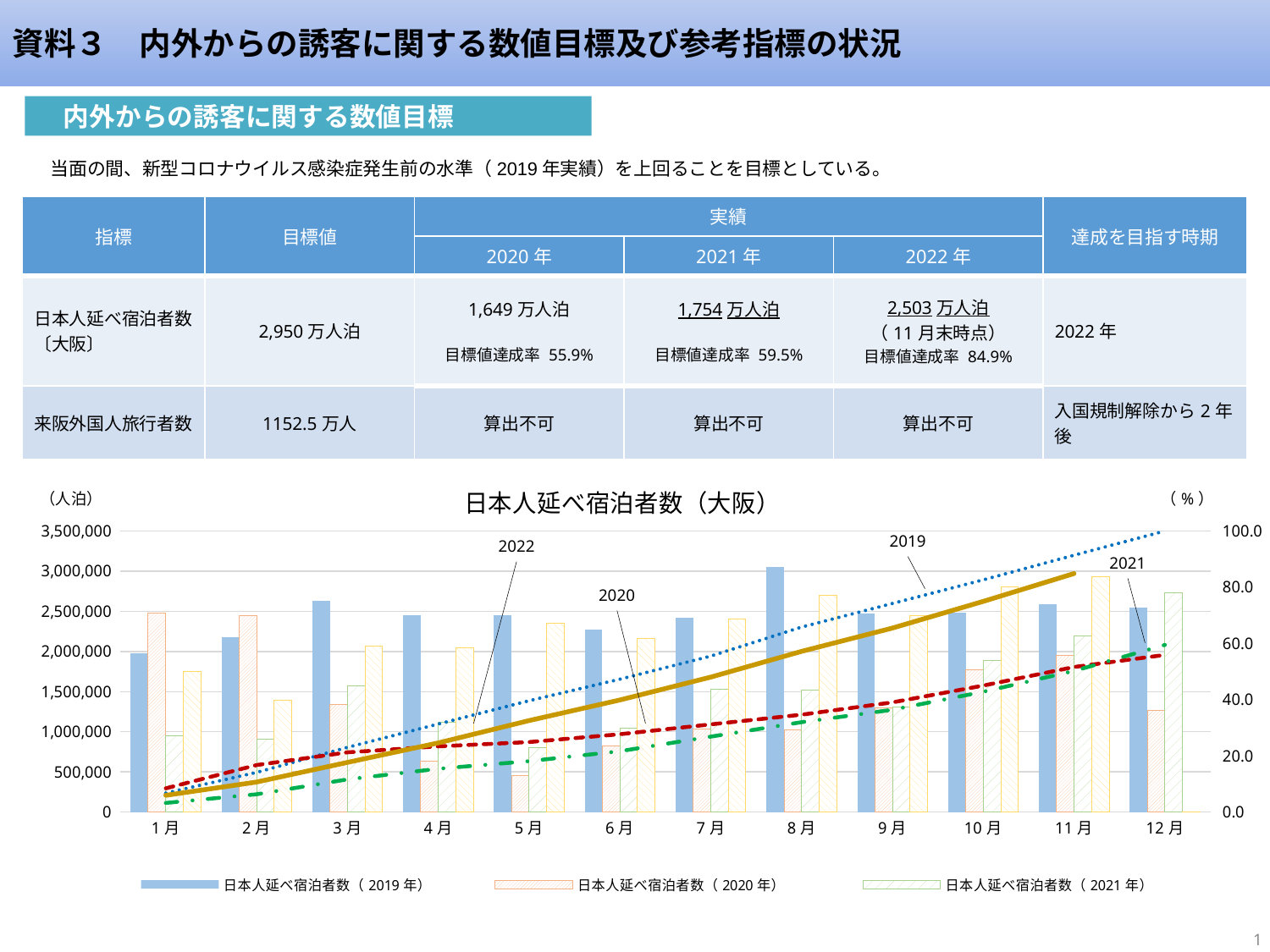
Is the value for 日本人延べ宿泊者数（2020年） in 5月 greater or less than 500,000? less Which month has the highest value for 日本人延べ宿泊者数（2019年）? 8月 Is the value for 日本人延べ宿泊者数（2019年） in 8月 greater or less than 3,000,000? greater Is the value for 日本人延べ宿泊者数（2020年） in 4月 greater or less than 1,000,000? less How many months are shown on the x axis of the chart? 12 What kind of chart is shown on the slide? bar chart with line series Which month has the lowest value for 日本人延べ宿泊者数（2020年）? 5月 Does the dotted line labelled 2019 rise or fall from 1月 to 12月? rise How many series does the chart legend list? 3 Which is larger in 5月: 日本人延べ宿泊者数（2019年） or 日本人延べ宿泊者数（2020年）? 日本人延べ宿泊者数（2019年） What is the maximum value shown on the right-hand (%) axis of the chart? 100.0 What is the title of the chart? 日本人延べ宿泊者数（大阪）